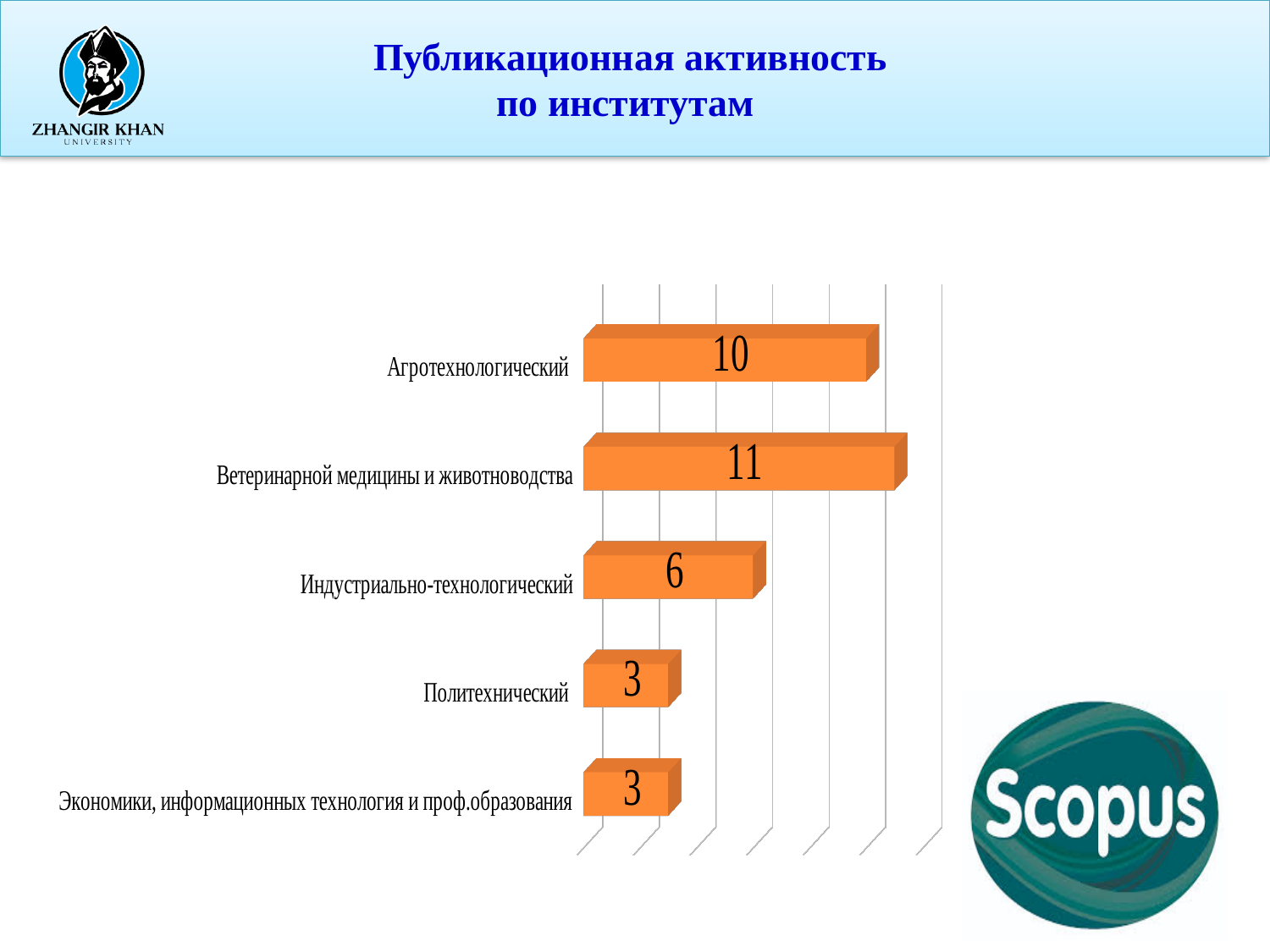
What is the value for Ветеринарной медицины и животноводства? 11 Which is larger, the value for Индустриально-технологический or the value for Политехнический? Индустриально-технологический What is the difference between the values for Агротехнологический and Индустриально-технологический? 4 What kind of chart is shown on the slide? Bar chart What is the difference between the values for Ветеринарной медицины и животноводства and Агротехнологический? 1 What is the lowest value shown in the chart? 3 What is the value for Экономики, информационных технология и проф.образования? 3 What is the value for Индустриально-технологический? 6 What is the value for Политехнический? 3 Which institute has the highest value? Ветеринарной медицины и животноводства What is the value for Агротехнологический? 10 How many institutes are shown in the chart? 5